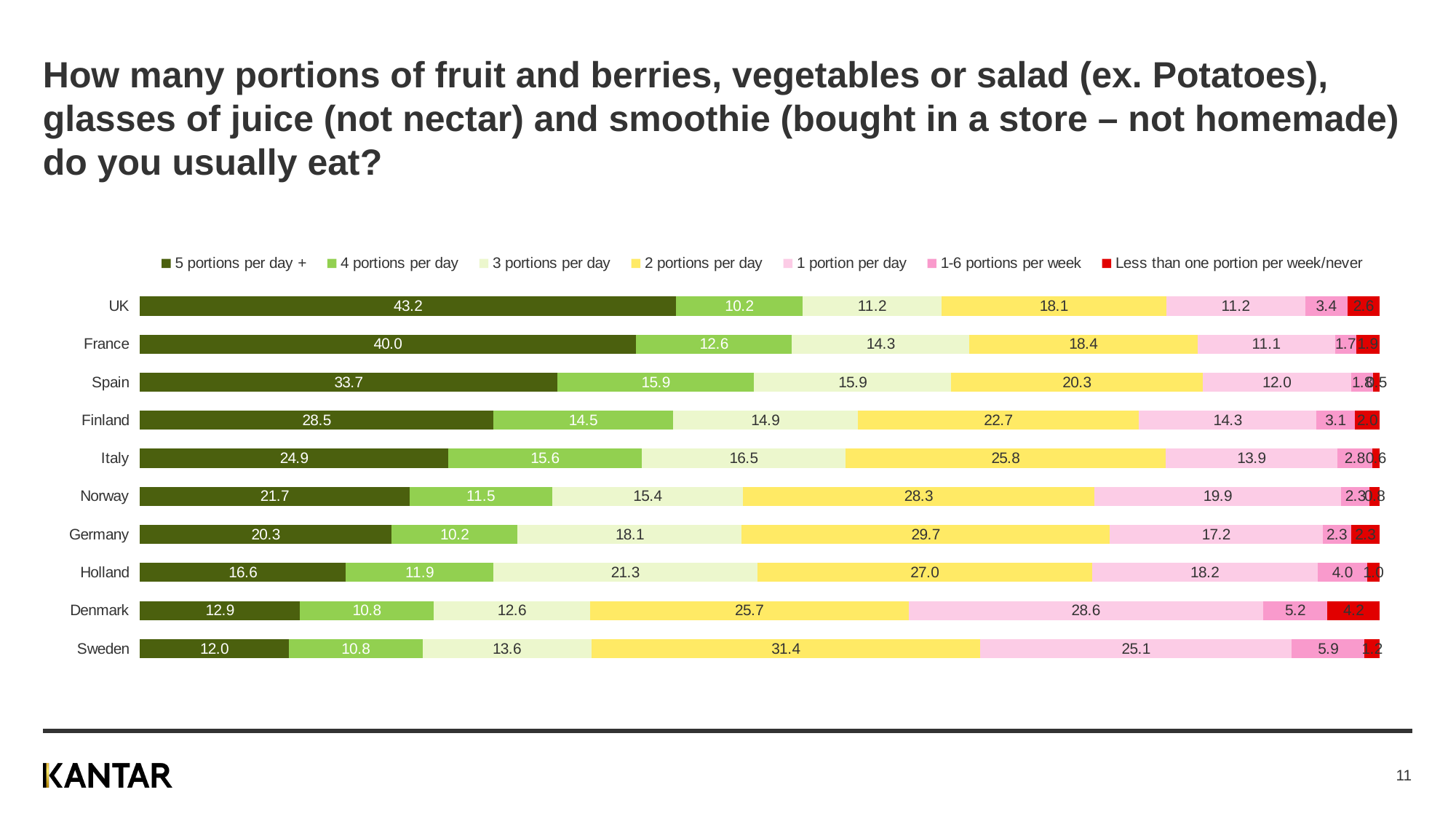
What is the value for '5 portions per day +' for the UK? 43.2 What is the value for '2 portions per day' for Sweden? 31.4 How many countries are shown in the chart? 10 What kind of chart is shown on the slide? Stacked bar chart Which country has the lowest value for '5 portions per day +'? Sweden How many series does the legend list? 7 What is the value for '1 portion per day' for Denmark? 28.6 Which country has the highest value for '5 portions per day +'? UK What is the difference between the '5 portions per day +' values for the UK and France? 3.2 Which is larger: the '2 portions per day' value for Germany or for Norway? Germany What is the total of the stacked bar for the UK? 99.9 What is the value for '3 portions per day' for Holland? 21.3